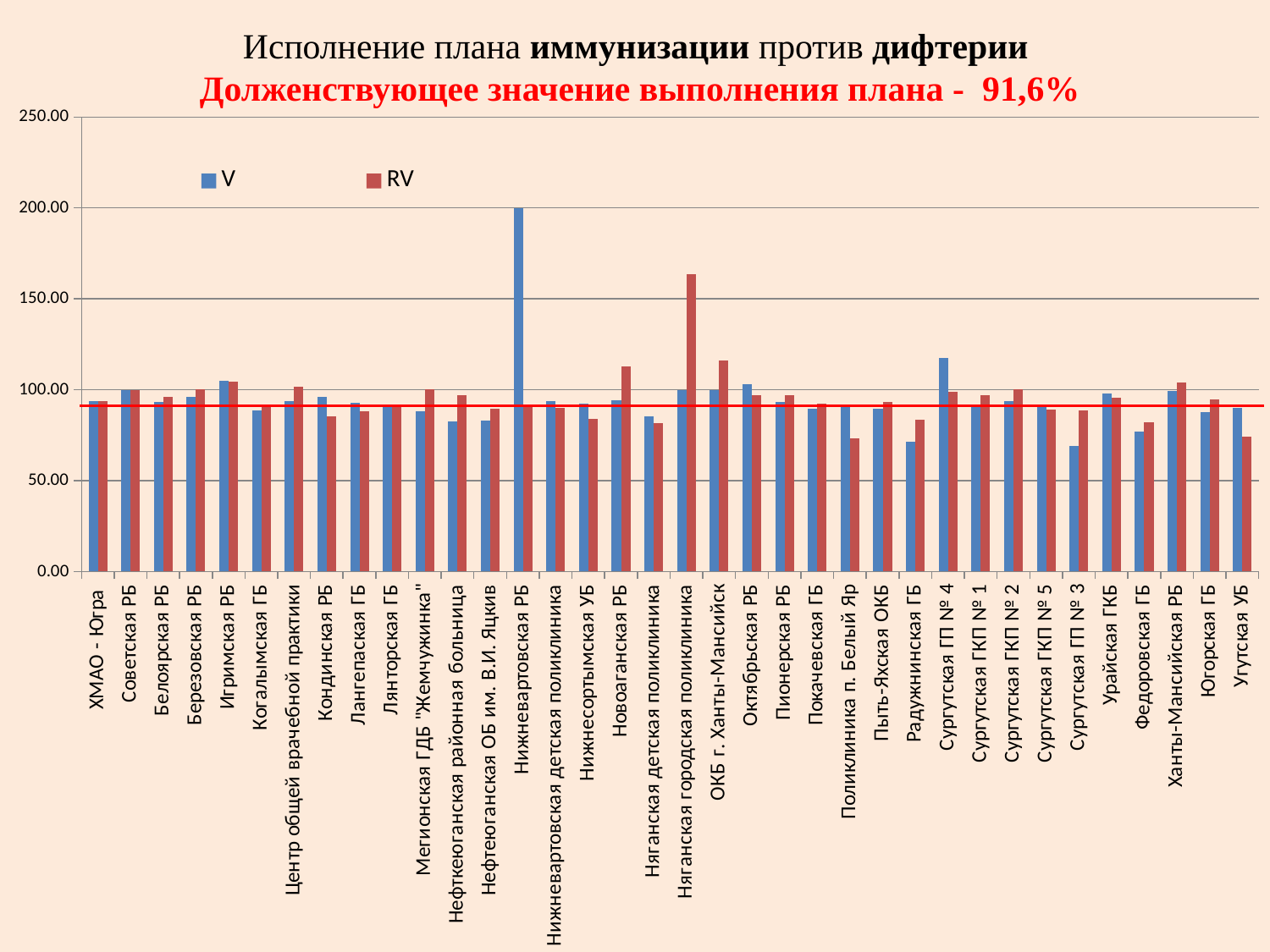
What target value for plan fulfilment is stated in the chart subtitle? 91,6% Is the RV value for Няганская городская поликлиника greater or less than 150? greater How many categories (institutions) are shown on the x axis? 36 Is the RV value for Новоаганская РБ greater or less than 100? greater What are the names of the two series in the legend? V and RV What kind of chart is shown on the slide? bar chart Which category has the highest value for the RV series? Няганская городская поликлиника Is the V value for Сургутская ГП № 3 greater or less than 100? less Which category has the highest value for the V series? Нижневартовская РБ For Няганская городская поликлиника, which series has the larger value, V or RV? RV How many series does the legend list? 2